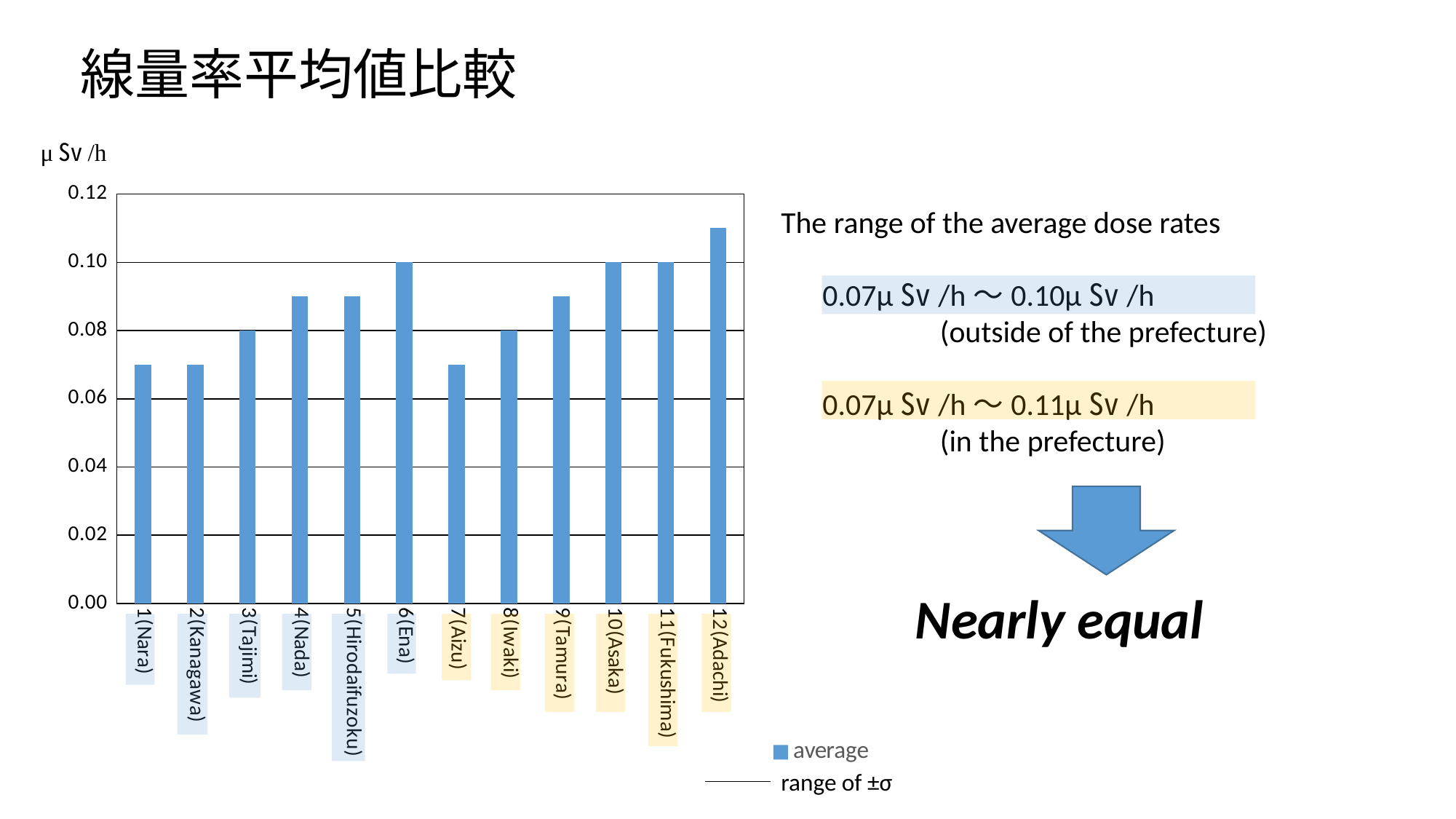
Which has a larger average dose rate, 12(Adachi) or 7(Aizu)? 12(Adachi) What is the average dose rate for 3(Tajimi)? 0.08 What type of chart is shown on the slide? bar chart How many entries does the chart legend list? 2 Is the value for 1(Nara) greater or less than 0.08? less What unit is shown above the y axis of the chart? μ Sv /h Is the value for 12(Adachi) greater or less than 0.10? greater How many locations are plotted on the x axis of the chart? 12 What is the average dose rate for 6(Ena)? 0.10 What is the difference between the average dose rates of 6(Ena) and 3(Tajimi)? 0.02 Which location has the highest average dose rate in the chart? 12(Adachi) What is the average dose rate for 11(Fukushima)? 0.10